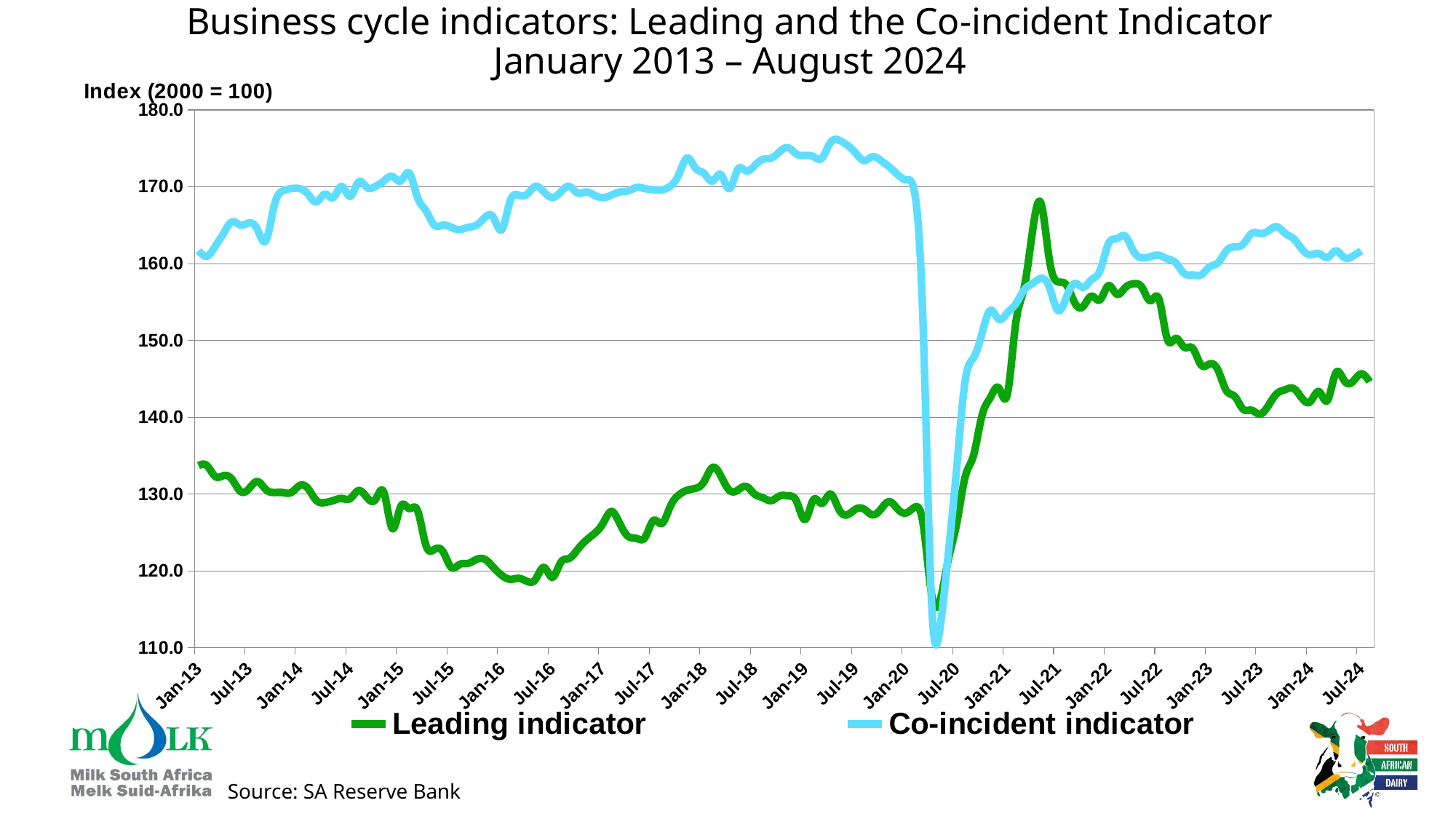
Is the value of the Leading indicator at Jan-16 greater or less than 130? less At Jan-18, which series has the higher value, the Leading indicator or the Co-incident indicator? Co-incident indicator How many series does the legend list? 2 Is the value of the Co-incident indicator at Jan-19 greater or less than 170? greater Which series reaches the lowest value shown on the chart? Co-incident indicator What kind of chart is shown on the slide? Line chart Is the value of the Leading indicator at Jul-23 greater or less than 150? less Does the Leading indicator rise or fall between Jan-13 and Jan-16? Fall What is the title of the chart? Business cycle indicators: Leading and the Co-incident Indicator January 2013 – August 2024 Which colour is used for the Co-incident indicator line? Light blue